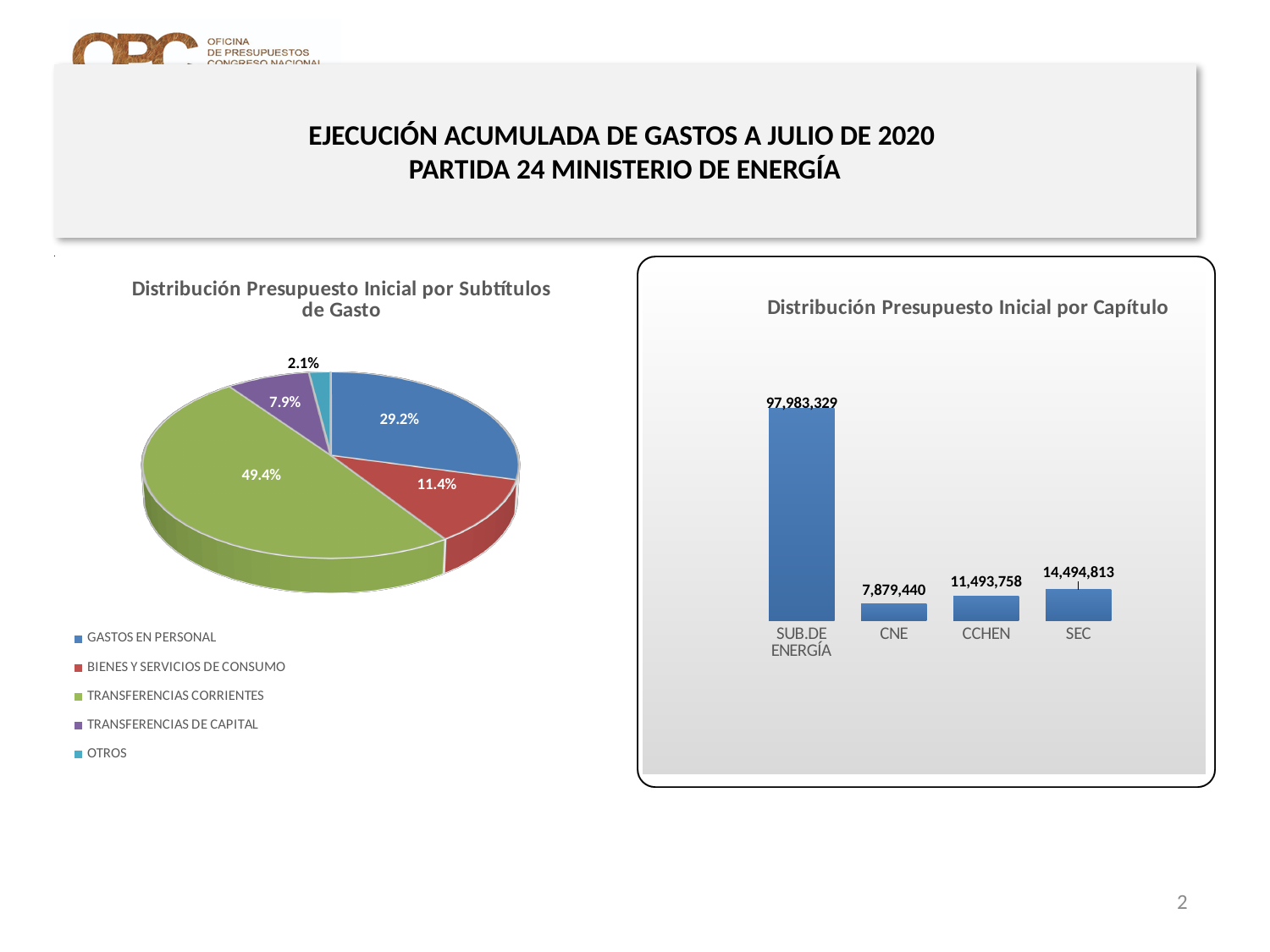
In the 'Distribución Presupuesto Inicial por Subtítulos de Gasto' chart, how many categories does the legend list? 5 In the 'Distribución Presupuesto Inicial por Capítulo' chart, what is the value for CCHEN? 11,493,758 What kind of chart is 'Distribución Presupuesto Inicial por Subtítulos de Gasto'? Pie chart In the 'Distribución Presupuesto Inicial por Capítulo' chart, what is the value for SUB.DE ENERGÍA? 97,983,329 In the 'Distribución Presupuesto Inicial por Subtítulos de Gasto' chart, which category has the largest slice? TRANSFERENCIAS CORRIENTES In the 'Distribución Presupuesto Inicial por Subtítulos de Gasto' chart, what share does GASTOS EN PERSONAL have? 29.2% In the 'Distribución Presupuesto Inicial por Subtítulos de Gasto' chart, which category has the smallest slice? OTROS In the 'Distribución Presupuesto Inicial por Capítulo' chart, which is larger, CCHEN or SEC? SEC In the 'Distribución Presupuesto Inicial por Subtítulos de Gasto' chart, what share does TRANSFERENCIAS CORRIENTES have? 49.4% In the 'Distribución Presupuesto Inicial por Capítulo' chart, what is the difference between SEC and CNE? 6,615,373 In the 'Distribución Presupuesto Inicial por Capítulo' chart, which chapter has the lowest value? CNE What kind of chart is 'Distribución Presupuesto Inicial por Capítulo'? Bar chart